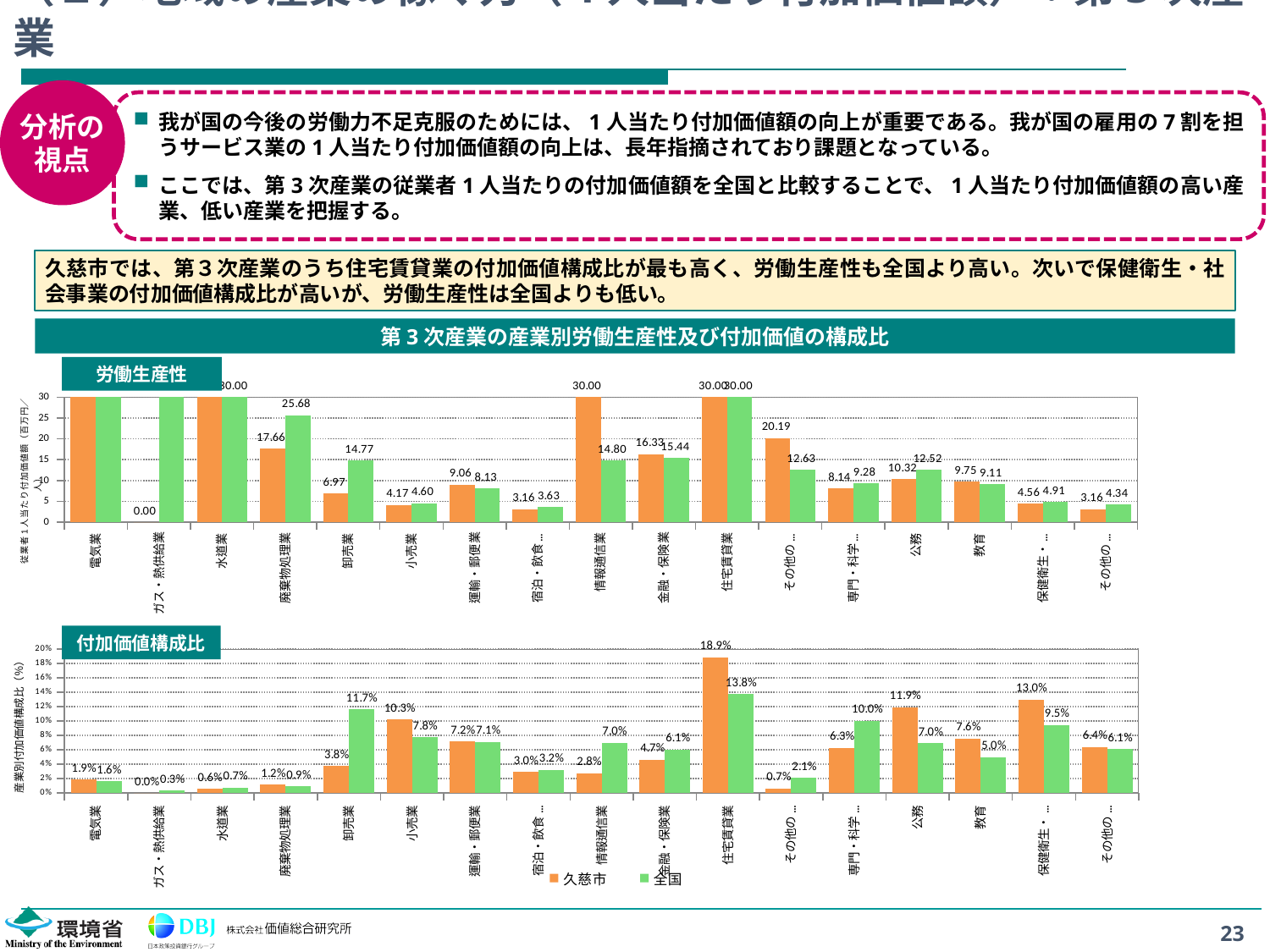
What kind of chart is the 労働生産性 chart? bar chart In the 労働生産性 chart, what is the difference between 全国 and 久慈市 in 卸売業? 7.80 In the 付加価値構成比 chart, what is the value for 久慈市 in 住宅賃貸業? 18.9% In the 労働生産性 chart, which is larger in 教育, 久慈市 or 全国? 久慈市 In the 労働生産性 chart, what is the value for 久慈市 in 廃棄物処理業? 17.66 In the 付加価値構成比 chart, which category has the lowest value for 久慈市? ガス・熱供給業 In the 付加価値構成比 chart, is the value for 久慈市 in 公務 greater or less than 10%? greater In the 労働生産性 chart, what is the value for 全国 in 公務? 12.52 In the 付加価値構成比 chart, what is the difference between 久慈市 and 全国 in 保健衛生・…? 3.5% In the 付加価値構成比 chart, what is the value for 全国 in 卸売業? 11.7% How many series does the legend of the 付加価値構成比 chart list? 2 In the 付加価値構成比 chart, which category has the highest value for 久慈市? 住宅賃貸業